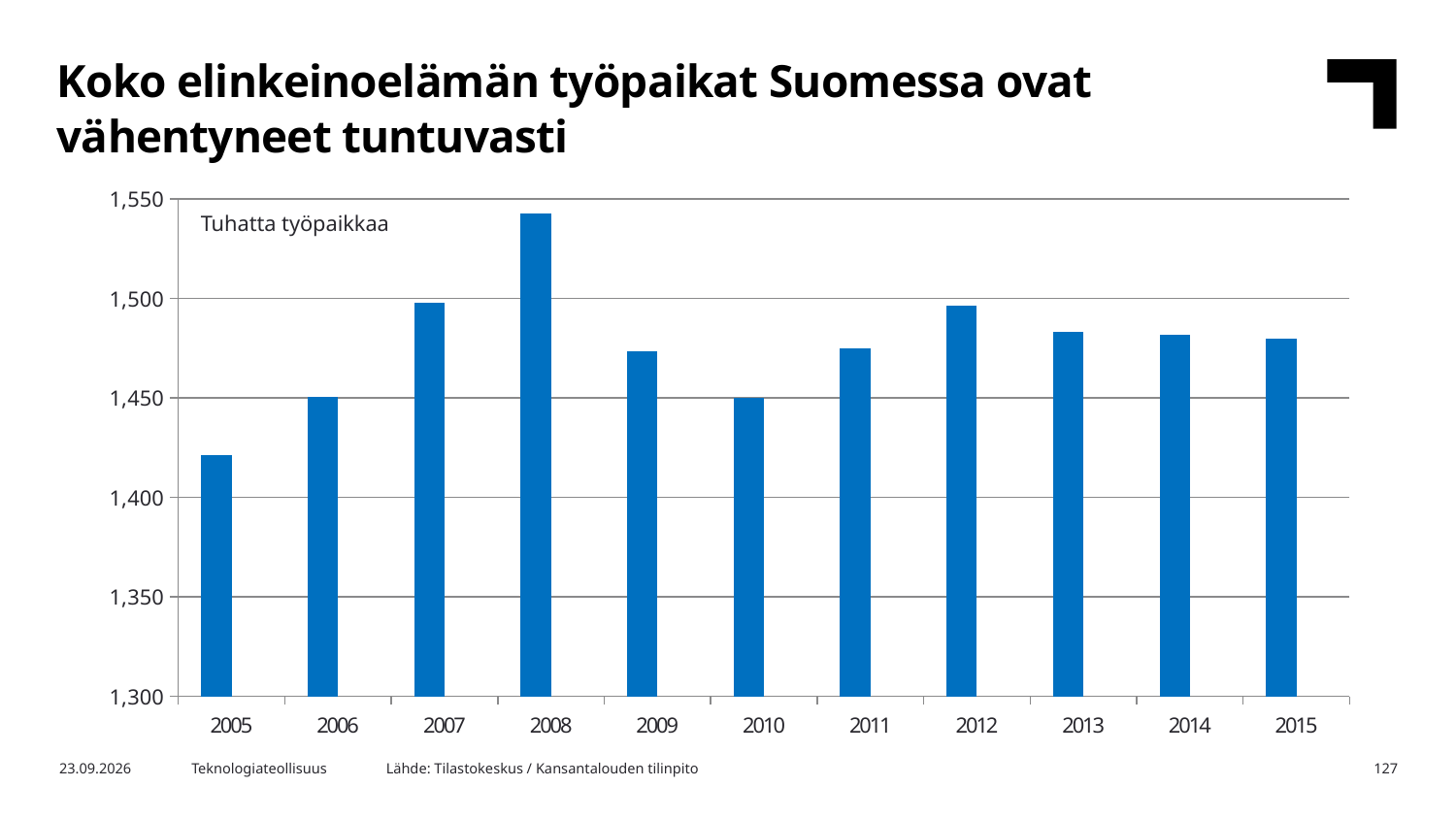
Do the values rise or fall from 2005 to 2008? rise Is the value for 2009 greater or less than 1,450? greater How many years are shown on the x axis of the chart? 11 Which year has the larger value, 2007 or 2009? 2007 What kind of chart is shown on the slide? bar chart Which year has the larger value, 2012 or 2010? 2012 What unit label is shown inside the chart area? Tuhatta työpaikkaa Is the value for 2013 greater or less than 1,500? less Which year has the lowest number of jobs in the chart? 2005 Is the value for 2005 greater or less than 1,450? less Which year has the highest number of jobs in the chart? 2008